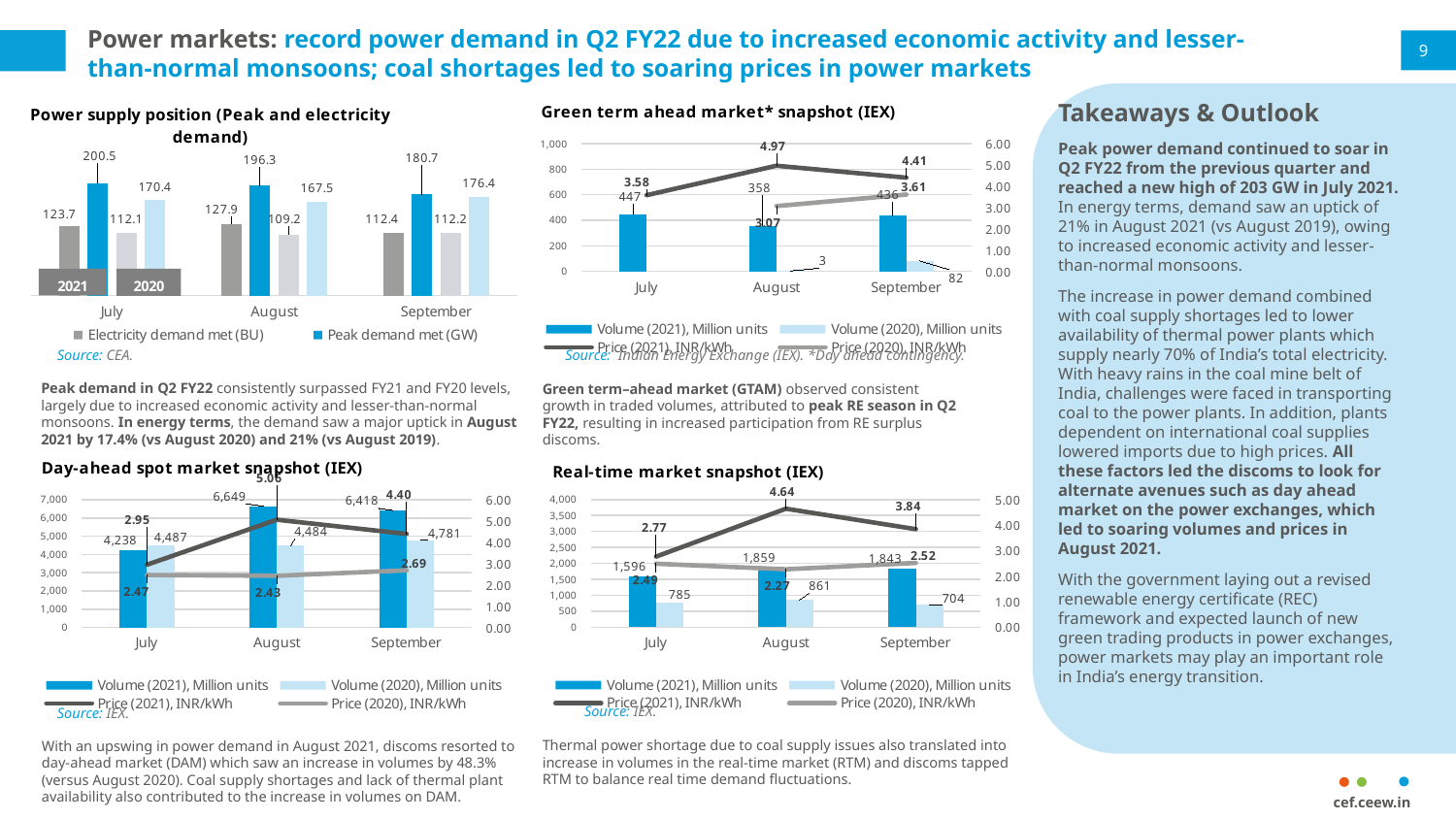
In the Real-time market snapshot (IEX) chart, what is the Volume (2020) for September? 704 In the Day-ahead spot market snapshot (IEX) chart, does the Price (2020) rise or fall from July to August? fall In the Power supply position chart, which is larger: Peak demand met (GW) in September 2021 or September 2020? September 2021 In the Power supply position chart, what is the Peak demand met (GW) for July 2021? 200.5 In the Green term ahead market snapshot (IEX) chart, which month has the lowest Volume (2021)? August How many months are shown on the x axis of the Green term ahead market snapshot (IEX) chart? 3 In the Day-ahead spot market snapshot (IEX) chart, what is the Volume (2021) for August? 6,649 In the Green term ahead market snapshot (IEX) chart, what is the Price (2021) for August? 4.97 How many series does the legend of the Real-time market snapshot (IEX) chart list? 4 In the Day-ahead spot market snapshot (IEX) chart, which month has the highest Price (2021)? August In the Power supply position chart, what is the difference between Electricity demand met (BU) in August 2021 and August 2020? 18.7 In the Real-time market snapshot (IEX) chart, what is the difference between Volume (2021) and Volume (2020) in July? 811